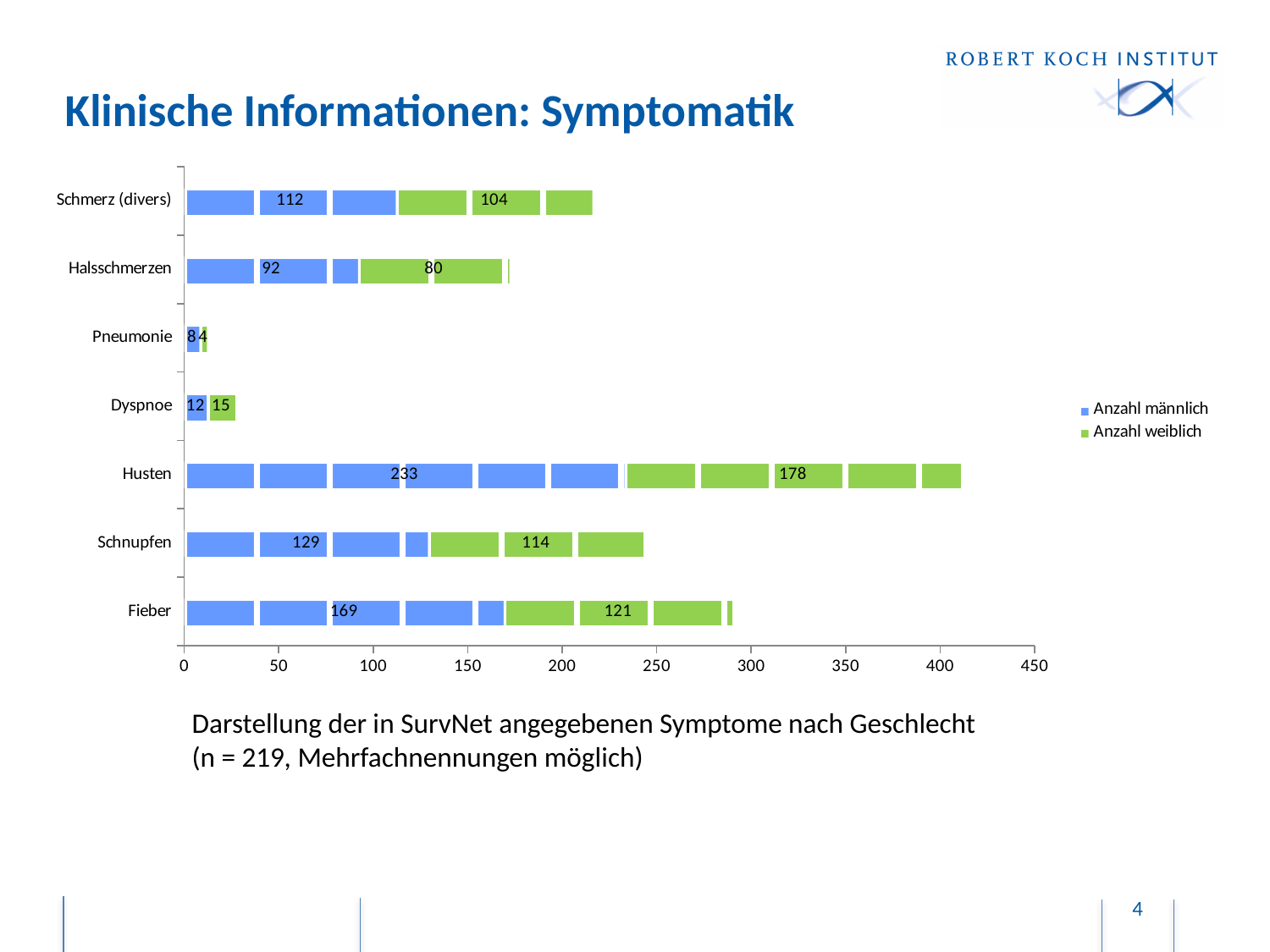
How many symptom categories are shown in the chart? 7 What is the value of Anzahl weiblich for Halsschmerzen? 80 Which symptom has the lowest value for Anzahl weiblich? Pneumonie What kind of chart is shown on the slide? Stacked bar chart How many series does the legend list? 2 What is the difference between Anzahl männlich and Anzahl weiblich for Schnupfen? 15 What is the value of Anzahl männlich for Husten? 233 What is the value of Anzahl weiblich for Fieber? 121 Which is larger for Dyspnoe, Anzahl männlich or Anzahl weiblich? Anzahl weiblich What is the total of the stacked bar for Fieber? 290 Which symptom has the highest value for Anzahl männlich? Husten What is the total of the stacked bar for Husten? 411